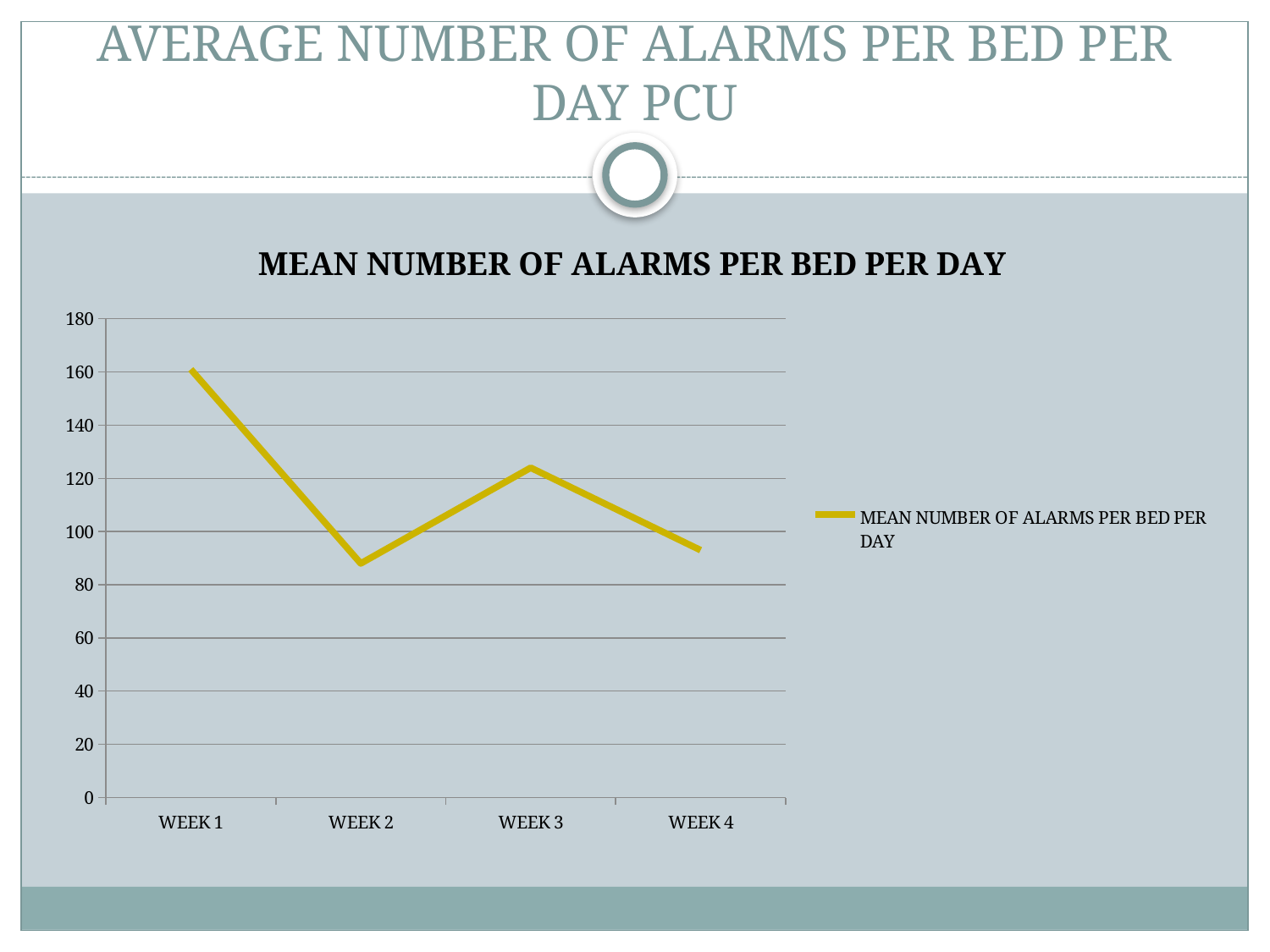
Does the value rise or fall from WEEK 1 to WEEK 2? fall Which week has the highest mean number of alarms per bed per day? WEEK 1 Is the value for WEEK 2 greater or less than 100? less How many weeks are plotted on the x axis? 4 Is the value for WEEK 3 greater or less than 120? greater What is the title of the chart? MEAN NUMBER OF ALARMS PER BED PER DAY What colour is the plotted line? yellow How many series does the legend list? 1 Which is larger, the value for WEEK 1 or the value for WEEK 3? WEEK 1 What kind of chart is shown on the slide? line chart Is the value for WEEK 1 greater or less than 140? greater